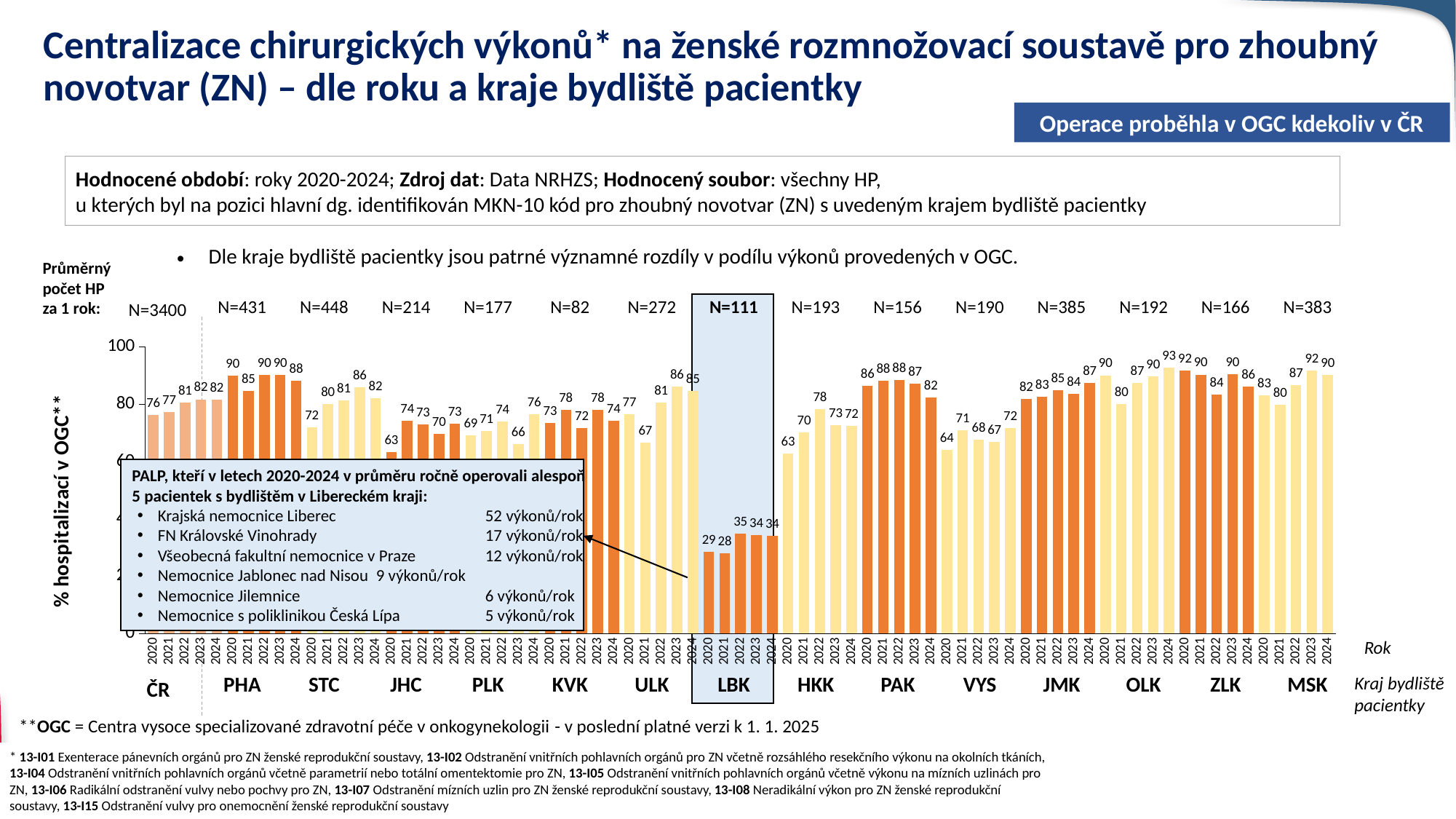
What is the value for OLK in 2024? 93 What is the average annual number of hospitalizations (N) shown for LBK? N=111 Do the values for ČR rise or fall from 2020 to 2024? rise Which region has the lowest values across all years? LBK What kind of chart is this? bar chart Which is larger, the value for PHA in 2020 or the value for STC in 2020? PHA in 2020 What is the difference between the ČR value in 2024 and the ČR value in 2020? 6 Is the value for LBK in 2022 greater or less than 40? less What is the value for ČR in 2024? 82 Which year has the highest value for MSK? 2023 What is the value for LBK in 2021? 28 How many years are shown for each region? 5